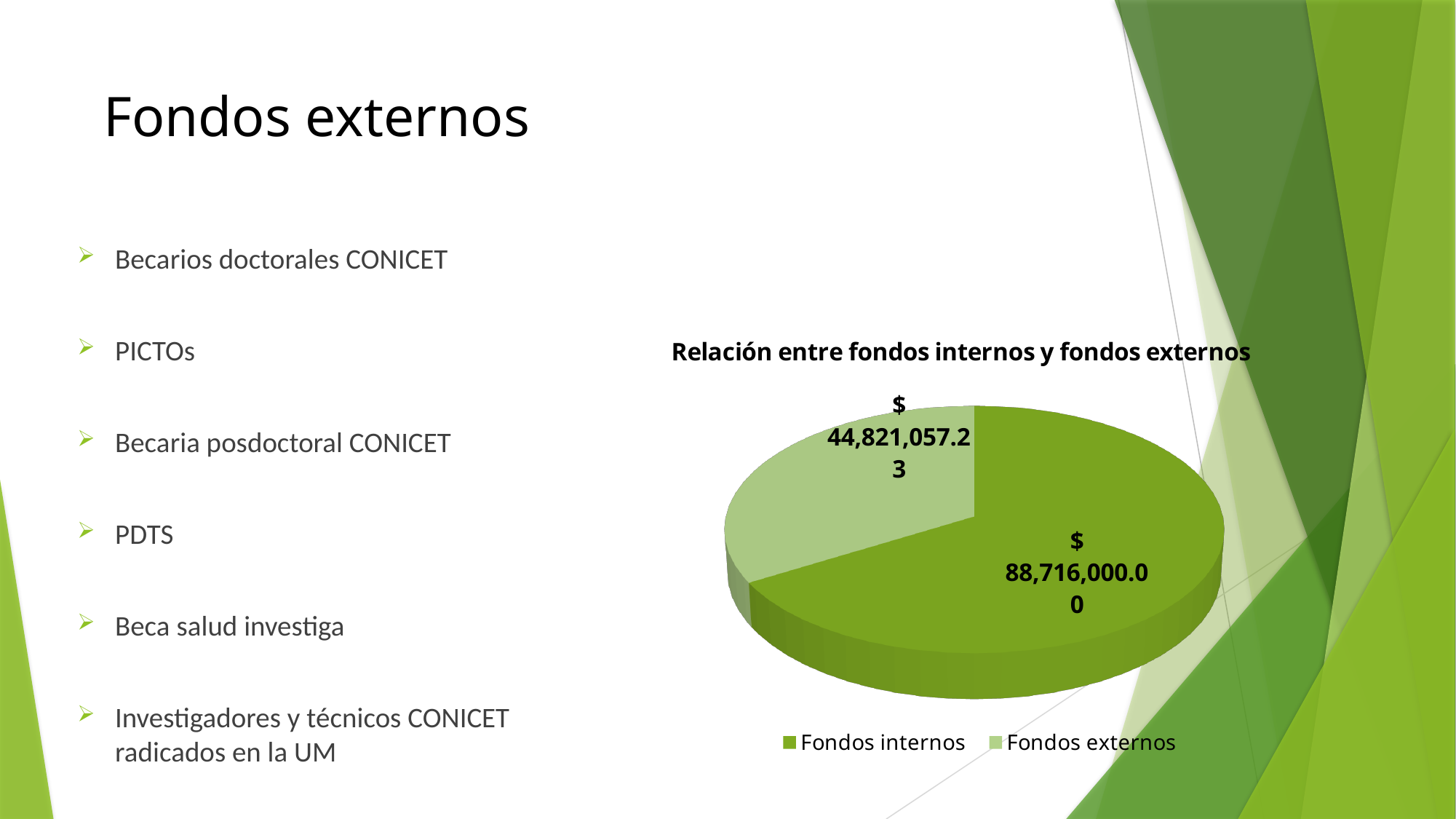
Which is larger, Fondos internos or Fondos externos? Fondos internos How many entries does the chart legend list? 2 What is the value for Fondos internos in the pie chart? $ 88,716,000.00 Which category has the largest slice in the pie chart? Fondos internos How many slices does the pie chart have? 2 Which legend entry is shown in the lighter green colour? Fondos externos What is the total of Fondos internos and Fondos externos shown in the pie chart? $ 133,537,057.23 What is the value for Fondos externos in the pie chart? $ 44,821,057.23 What kind of chart is shown on the slide? Pie chart What is the difference between Fondos internos and Fondos externos? $ 43,894,942.77 What is the title of the chart? Relación entre fondos internos y fondos externos Which category has the smallest slice in the pie chart? Fondos externos